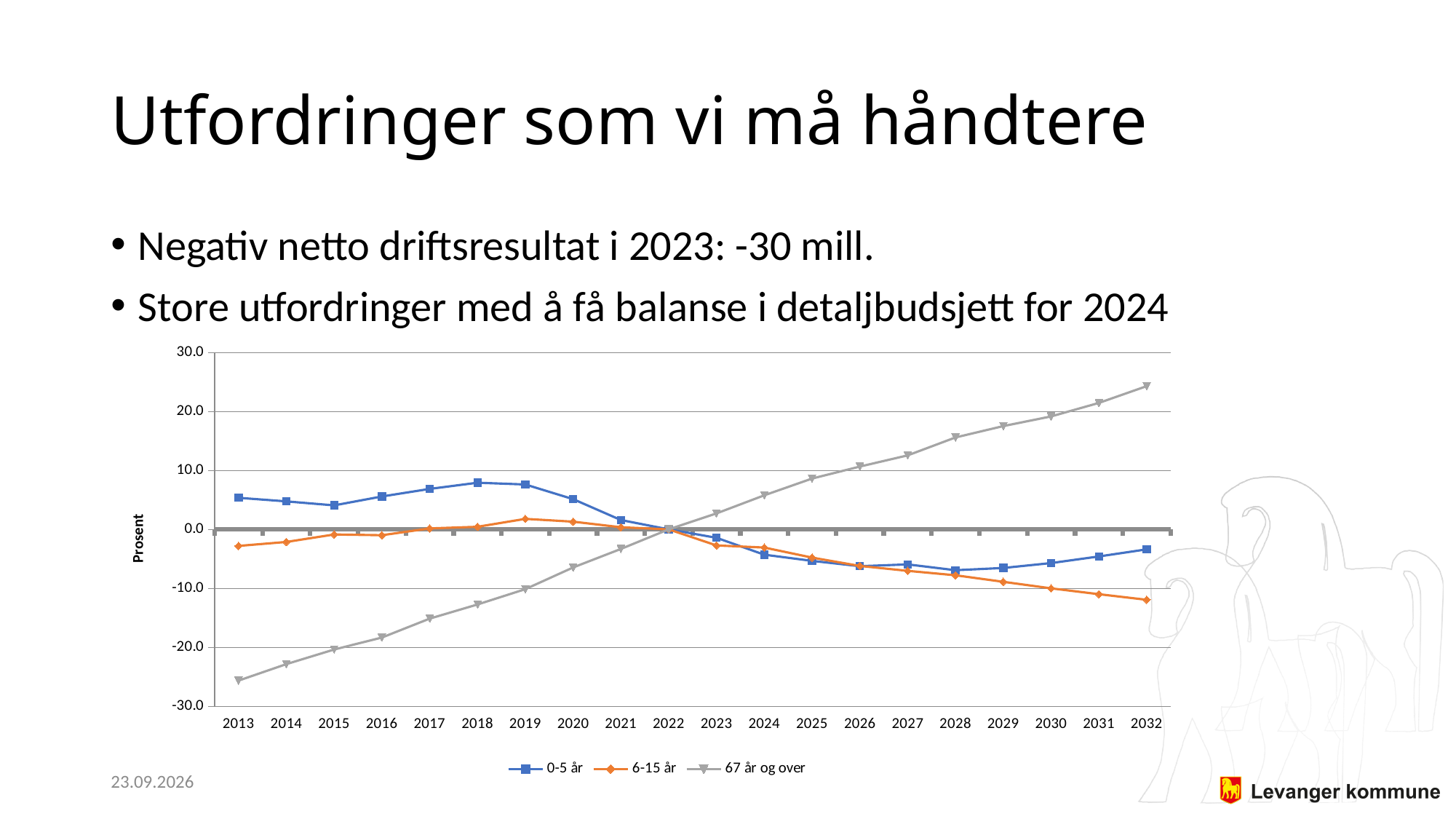
What is the label on the vertical axis? Prosent Is the value for '67 år og over' in 2013 greater or less than -20.0? less Does the value for '67 år og over' rise or fall from 2013 to 2032? rise Does the value for '6-15 år' rise or fall from 2022 to 2032? fall How many series does the legend list? 3 Which series has the highest value in 2032? 67 år og over Which series has the lowest value in 2032? 6-15 år How many years are shown along the x axis? 20 Which series are listed in the legend? 0-5 år, 6-15 år, 67 år og over Is the value for '67 år og over' in 2032 greater or less than 20.0? greater What is the value for '0-5 år' in 2022? 0.0 What kind of chart is shown on the slide? line chart